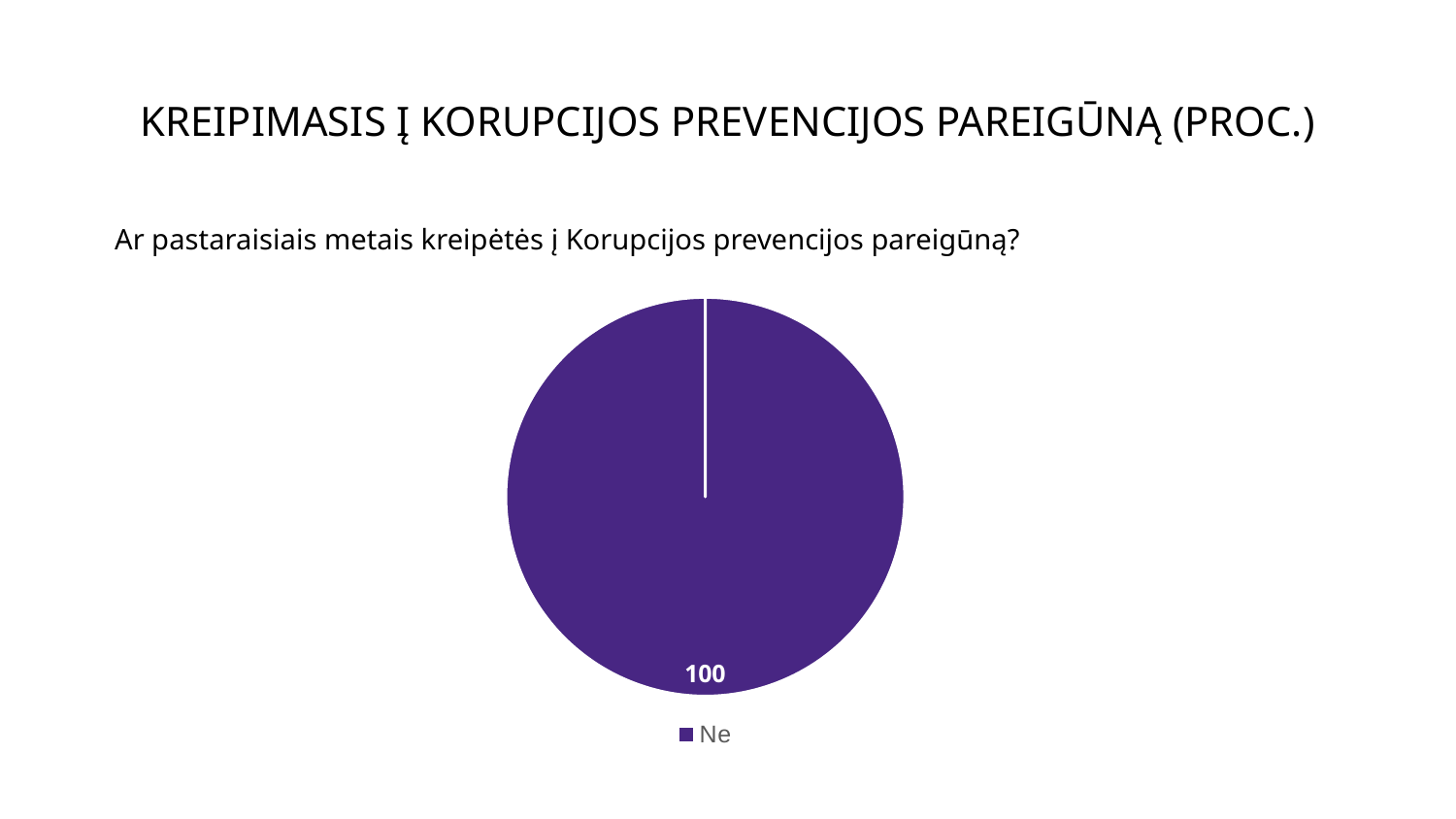
What is the only category listed in the legend? Ne How many entries does the legend list? 1 What is the value shown for the "Ne" slice? 100 Is the value for "Ne" greater or less than 50? greater How many slices does the pie chart have? 1 What is the title of the chart on the slide? KREIPIMASIS Į KORUPCIJOS PREVENCIJOS PAREIGŪNĄ (PROC.) What kind of chart is shown on the slide? pie chart What share of the pie does the "Ne" slice take up? 100%